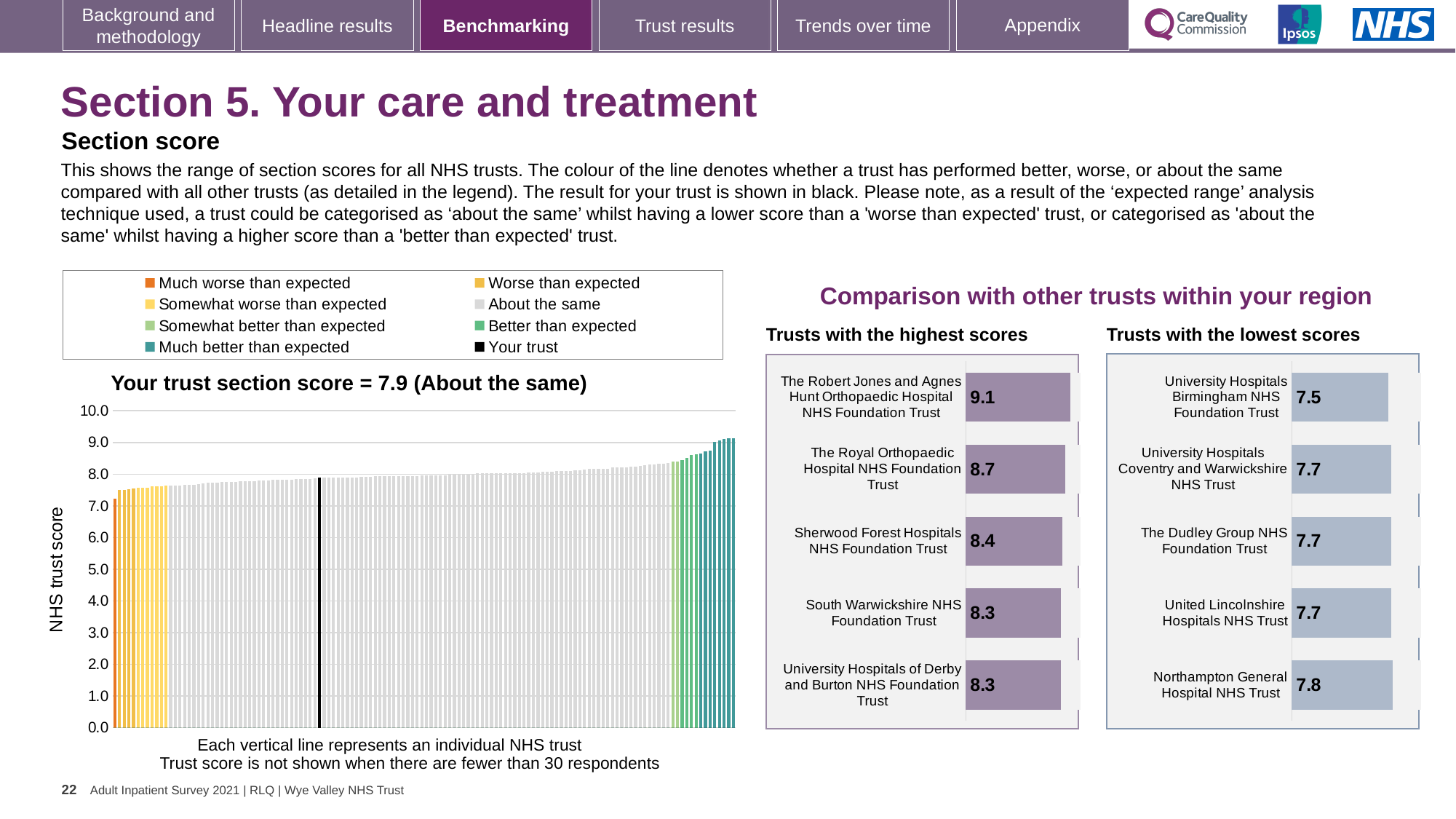
On the 'Your trust section score' chart, what is the label of the vertical axis? NHS trust score On the 'Trusts with the highest scores' chart, what is the difference between the scores of The Robert Jones and Agnes Hunt Orthopaedic Hospital NHS Foundation Trust and Sherwood Forest Hospitals NHS Foundation Trust? 0.7 On the 'Trusts with the highest scores' chart, what is the score for Sherwood Forest Hospitals NHS Foundation Trust? 8.4 On the 'Your trust section score' chart, which category is your trust placed in? About the same On the 'Your trust section score' chart, what is the section score for your trust? 7.9 On the 'Trusts with the lowest scores' chart, which trust has the lowest score? University Hospitals Birmingham NHS Foundation Trust On the 'Trusts with the highest scores' chart, which trust has the highest score? The Robert Jones and Agnes Hunt Orthopaedic Hospital NHS Foundation Trust On the 'Your trust section score' chart, how many entries does the legend list? 8 On the 'Your trust section score' chart, do the trust scores rise or fall from left to right along the x axis? Rise What kind of chart is the 'Your trust section score' chart? Bar chart On the 'Trusts with the lowest scores' chart, how many trusts are shown? 5 On the 'Trusts with the lowest scores' chart, what is the score for Northampton General Hospital NHS Trust? 7.8